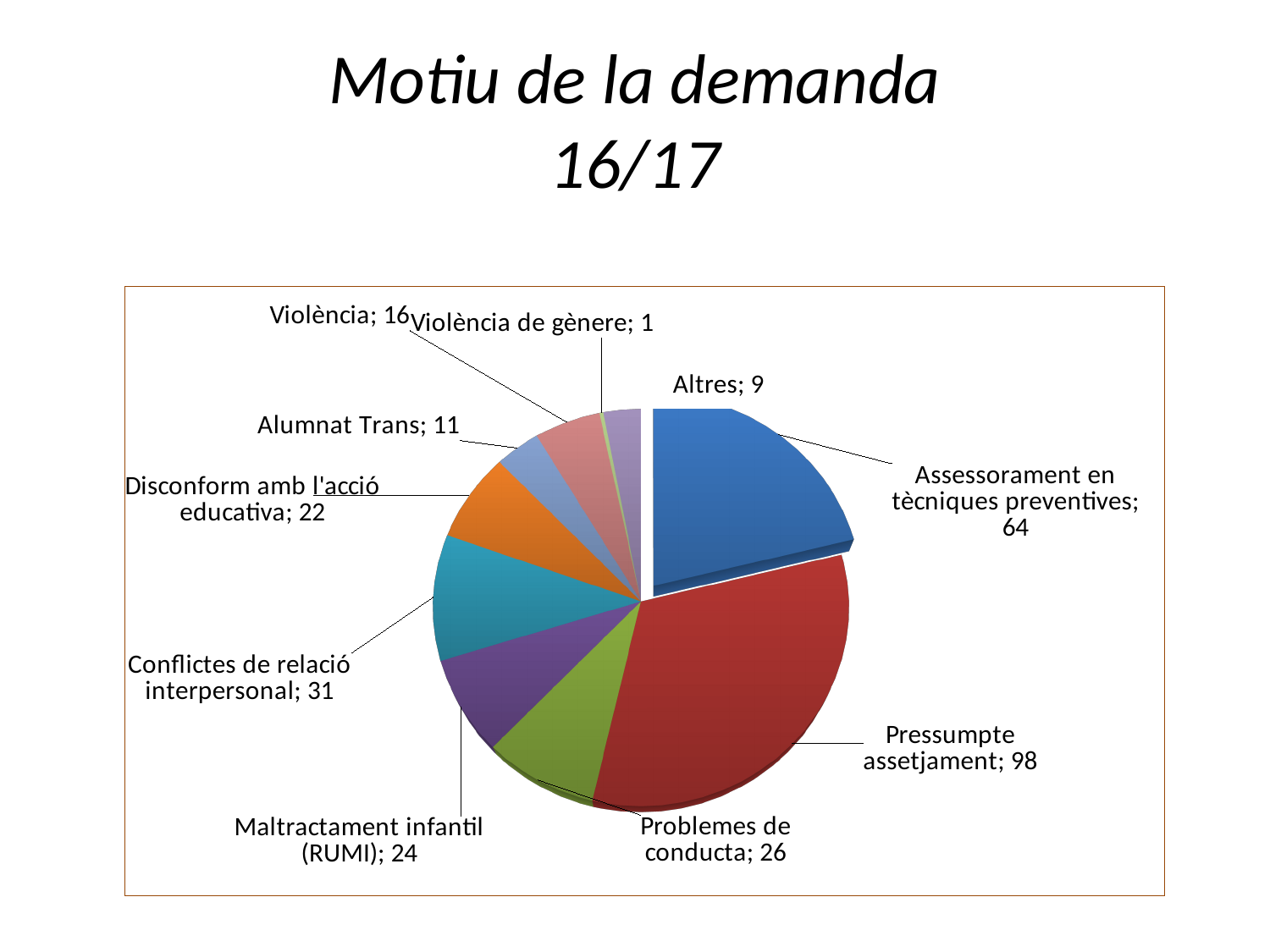
What is the value for Pressumpte assetjament? 98 What is the difference between Pressumpte assetjament and Assessorament en tècniques preventives? 34 Which category has the largest slice of the pie? Pressumpte assetjament What is the value for Alumnat Trans? 11 What is the value for Assessorament en tècniques preventives? 64 What is the value for Conflictes de relació interpersonal? 31 How many categories are shown in the pie chart? 10 What is the title of the slide? Motiu de la demanda 16/17 Which is larger, Violència or Altres? Violència Which category has the smallest slice of the pie? Violència de gènere What kind of chart is shown on the slide? Pie chart What is the difference between Problemes de conducta and Maltractament infantil (RUMI)? 2